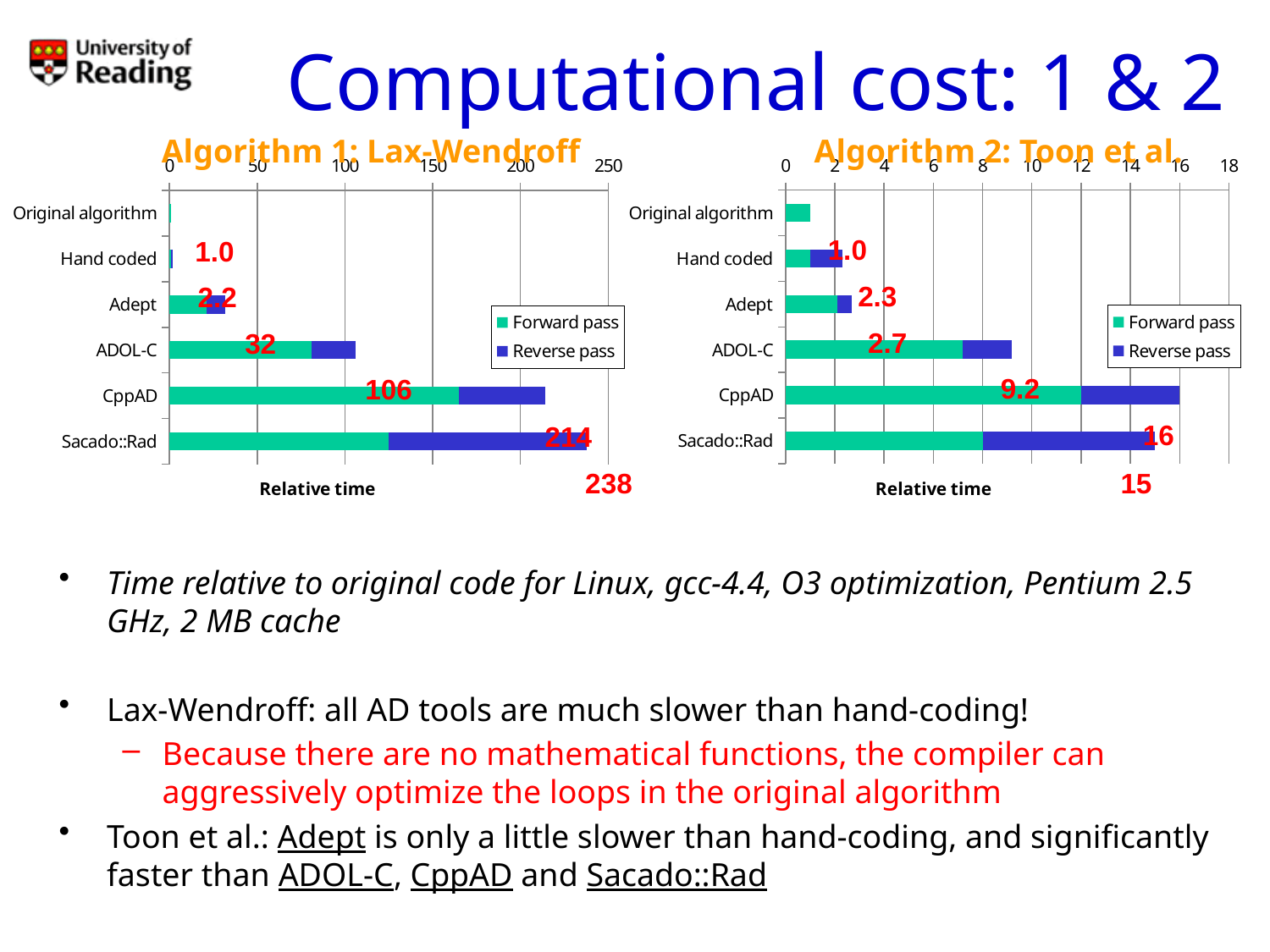
In the Algorithm 2: Toon et al. chart, which has the larger Forward pass value, CppAD or Sacado::Rad? CppAD How many series does the legend list in the Algorithm 2: Toon et al. chart? 2 How many categories are shown on the y axis of the Algorithm 1: Lax-Wendroff chart? 6 In the Algorithm 1: Lax-Wendroff chart, which category has the shortest total bar? Original algorithm In the Algorithm 1: Lax-Wendroff chart, which category has the longest total bar? Sacado::Rad In the Algorithm 2: Toon et al. chart, which category has the shortest total bar? Original algorithm In the Algorithm 2: Toon et al. chart, is the total value for Adept greater or less than 4? less In the Algorithm 1: Lax-Wendroff chart, is the total value for ADOL-C greater or less than 150? less What type of chart is used for Algorithm 1: Lax-Wendroff? Bar chart In the Algorithm 2: Toon et al. chart, is the total value for ADOL-C greater or less than 8? greater What is the x-axis title of the Algorithm 1: Lax-Wendroff chart? Relative time